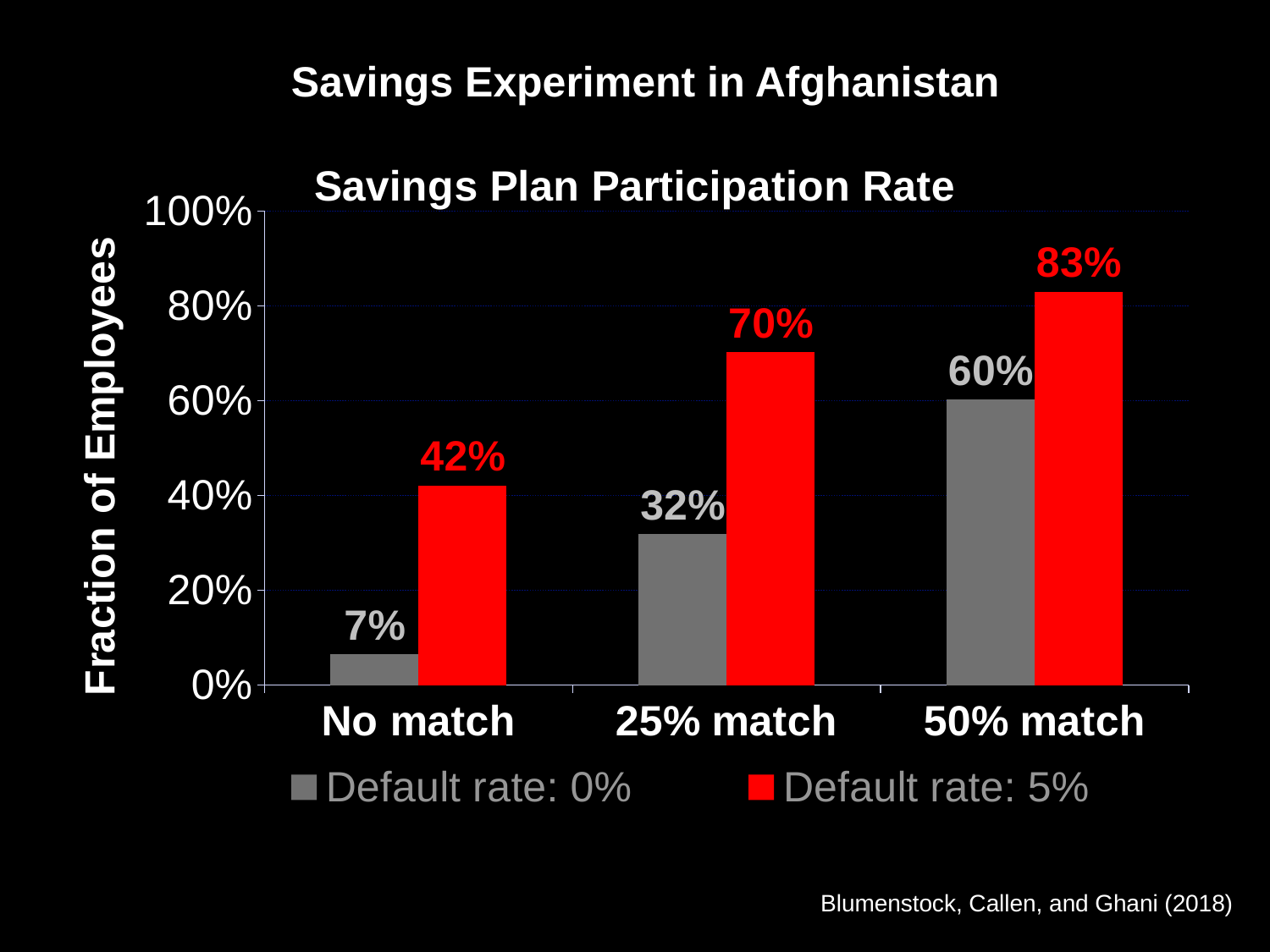
What kind of chart is shown on the slide? Bar chart Which match category has the lowest participation rate for the 'Default rate: 0%' series? No match What is the difference between the 'Default rate: 5%' and 'Default rate: 0%' values under 'No match'? 35% How many match categories are shown on the x axis? 3 What is the value for 'Default rate: 0%' under '50% match'? 60% What is the savings plan participation rate for the 'Default rate: 5%' series under '25% match'? 70% Do the 'Default rate: 5%' values rise or fall from 'No match' to '50% match'? Rise What is the difference between the 'Default rate: 5%' values for '50% match' and '25% match'? 13% How many series does the legend list? 2 What is the savings plan participation rate for the 'Default rate: 0%' series under 'No match'? 7% Which is larger: the 'Default rate: 0%' value under '50% match' or the 'Default rate: 5%' value under 'No match'? Default rate: 0% under 50% match Which match category has the highest participation rate for the 'Default rate: 5%' series? 50% match